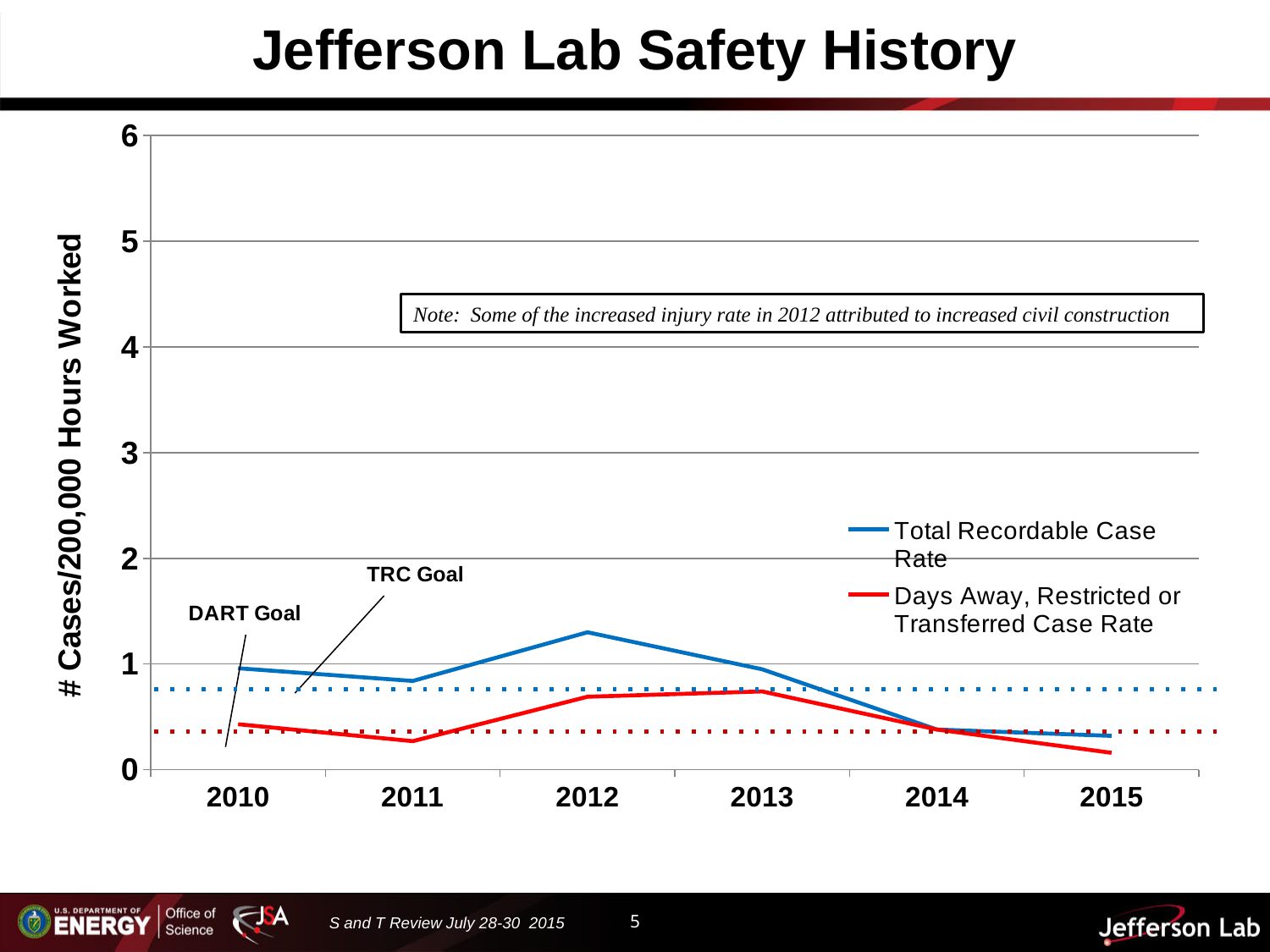
In which year is the Days Away, Restricted or Transferred Case Rate lowest? 2015 What kind of chart is shown on the slide? line chart Is the Total Recordable Case Rate in 2012 greater or less than 1? greater Does the Days Away, Restricted or Transferred Case Rate rise or fall from 2011 to 2013? rise How many years are plotted along the x axis? 6 In 2012, which is larger: the Total Recordable Case Rate or the Days Away, Restricted or Transferred Case Rate? Total Recordable Case Rate Is the Total Recordable Case Rate in 2014 greater or less than 1? less Does the Total Recordable Case Rate rise or fall from 2012 to 2015? fall What is the label on the y axis of the chart? # Cases/200,000 Hours Worked In which year is the Total Recordable Case Rate highest? 2012 Is the Days Away, Restricted or Transferred Case Rate in 2011 greater or less than 1? less How many series does the legend list? 2